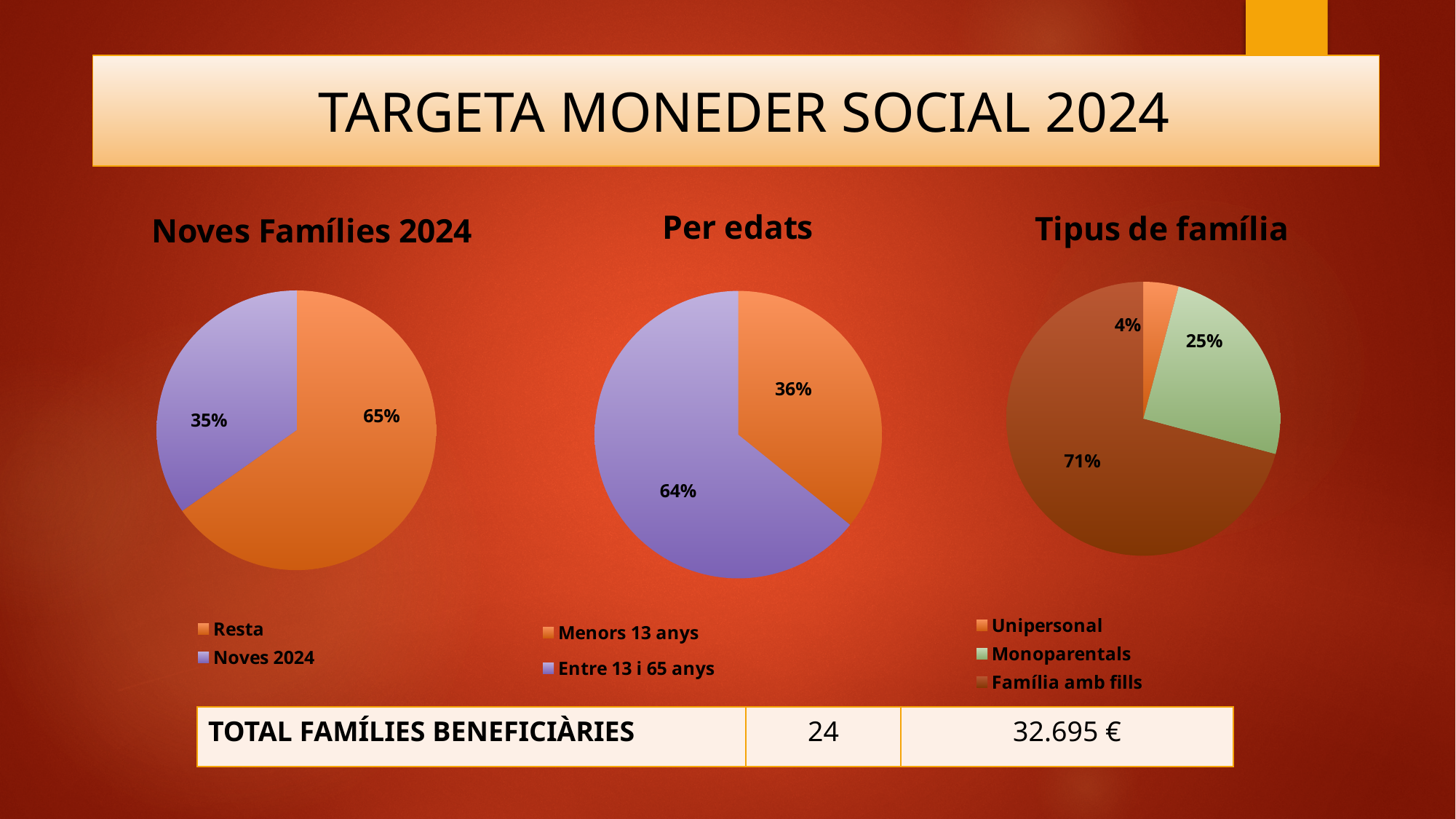
In the 'Tipus de família' chart, which category has the smallest share? Unipersonal In the 'Tipus de família' chart, what share does 'Unipersonal' have? 4% In the 'Noves Famílies 2024' chart, what share does 'Resta' have? 65% In the 'Tipus de família' chart, what is the difference between the 'Família amb fills' and 'Monoparentals' shares? 46% In the 'Per edats' chart, which category has the larger share? Entre 13 i 65 anys In the 'Noves Famílies 2024' chart, what is the difference between the 'Resta' and 'Noves 2024' shares? 30% What kind of chart is the 'Per edats' chart? Pie chart In the 'Per edats' chart, what share does 'Menors 13 anys' have? 36% In the 'Tipus de família' chart, how many categories are shown? 3